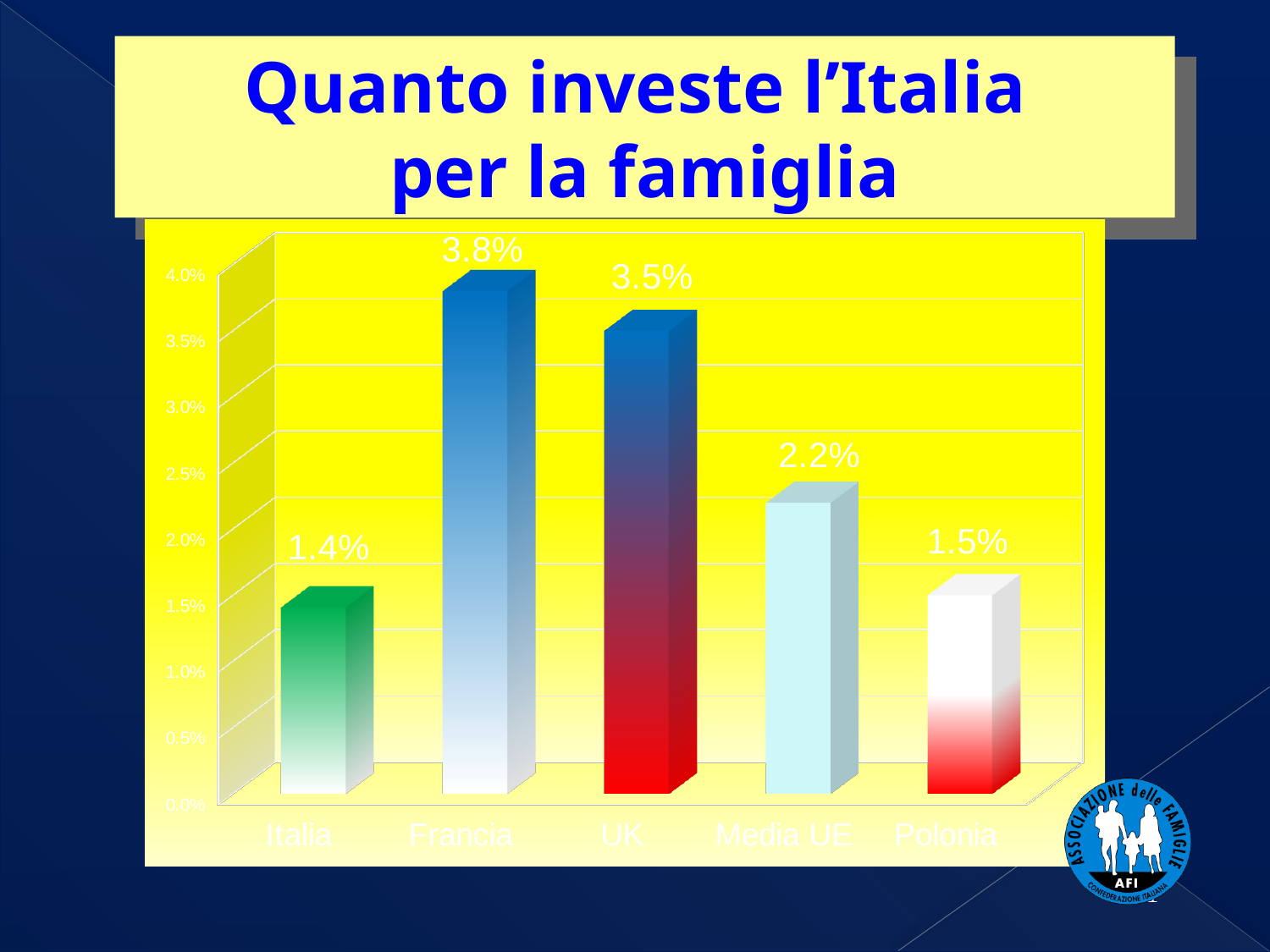
What kind of chart is shown on the slide? bar chart What is the value for Francia? 3.8% How many categories are shown on the x axis? 5 What is the value for Italia? 1.4% Which category has the lowest value? Italia Which category has the highest value? Francia What is the title of the slide? Quanto investe l'Italia per la famiglia What is the difference between the values for Francia and Italia? 2.4% Which is larger, the value for UK or the value for Media UE? UK What is the value for UK? 3.5% What is the value for Polonia? 1.5% What is the value for Media UE? 2.2%